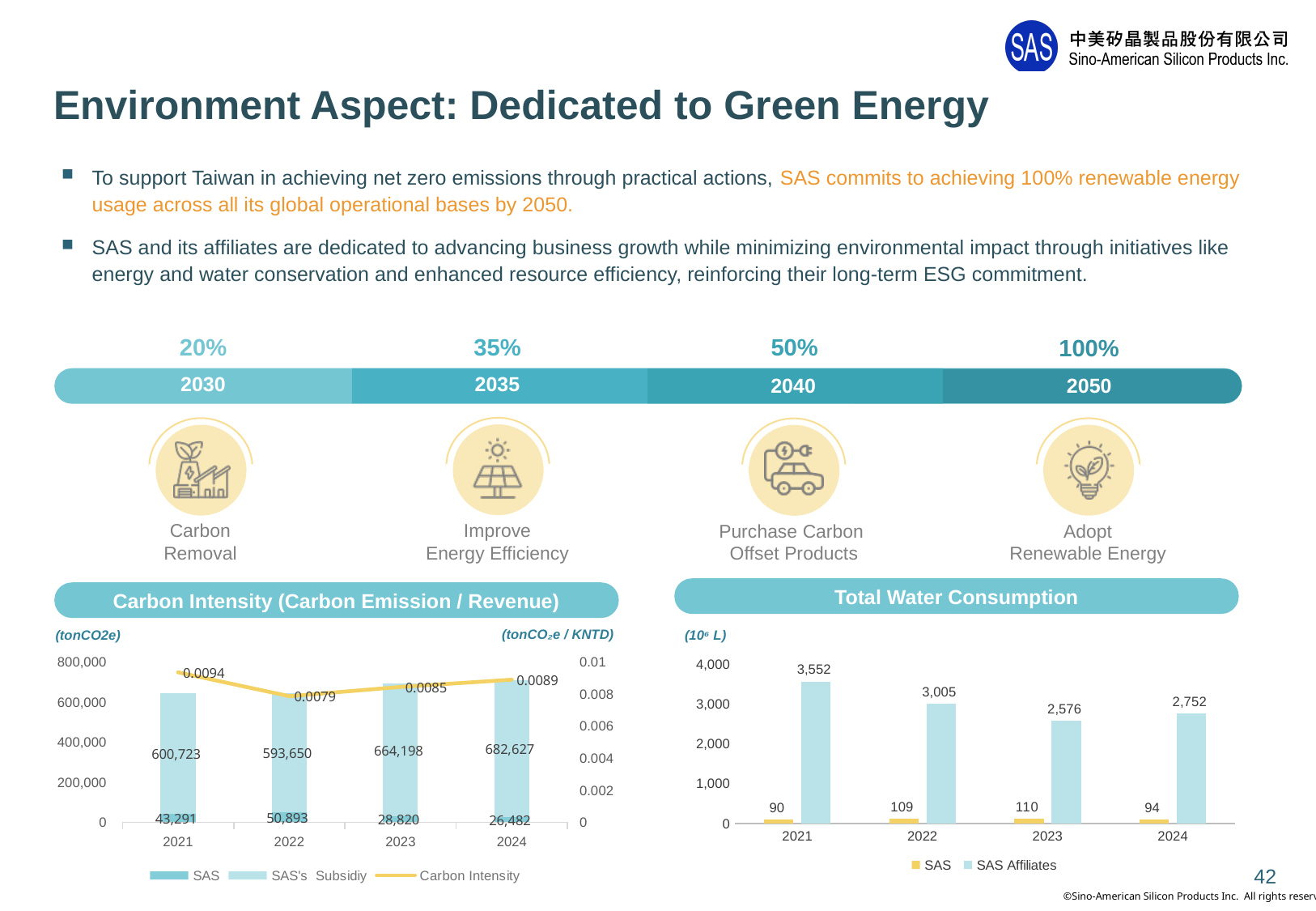
In the Total Water Consumption chart, what is the value for SAS in 2023? 110 In the Total Water Consumption chart, is the SAS value larger in 2022 or in 2024? 2022 What kind of chart is the Total Water Consumption chart? bar chart In the Total Water Consumption chart, what is the difference between the SAS Affiliates values for 2021 and 2024? 800 How many series does the legend of the Total Water Consumption chart list? 2 In the Total Water Consumption chart, which year has the highest value for SAS Affiliates? 2021 In the Carbon Intensity chart, what is the Carbon Intensity value for 2022? 0.0079 In the Carbon Intensity chart, does the Carbon Intensity line rise or fall from 2022 to 2024? rise In the Carbon Intensity chart, what is the larger bar value labelled for 2024? 682,627 In the Total Water Consumption chart, what is the value for SAS Affiliates in 2021? 3,552 In the Carbon Intensity chart, which year has the highest Carbon Intensity value? 2021 In the Total Water Consumption chart, which year has the lowest value for SAS Affiliates? 2023